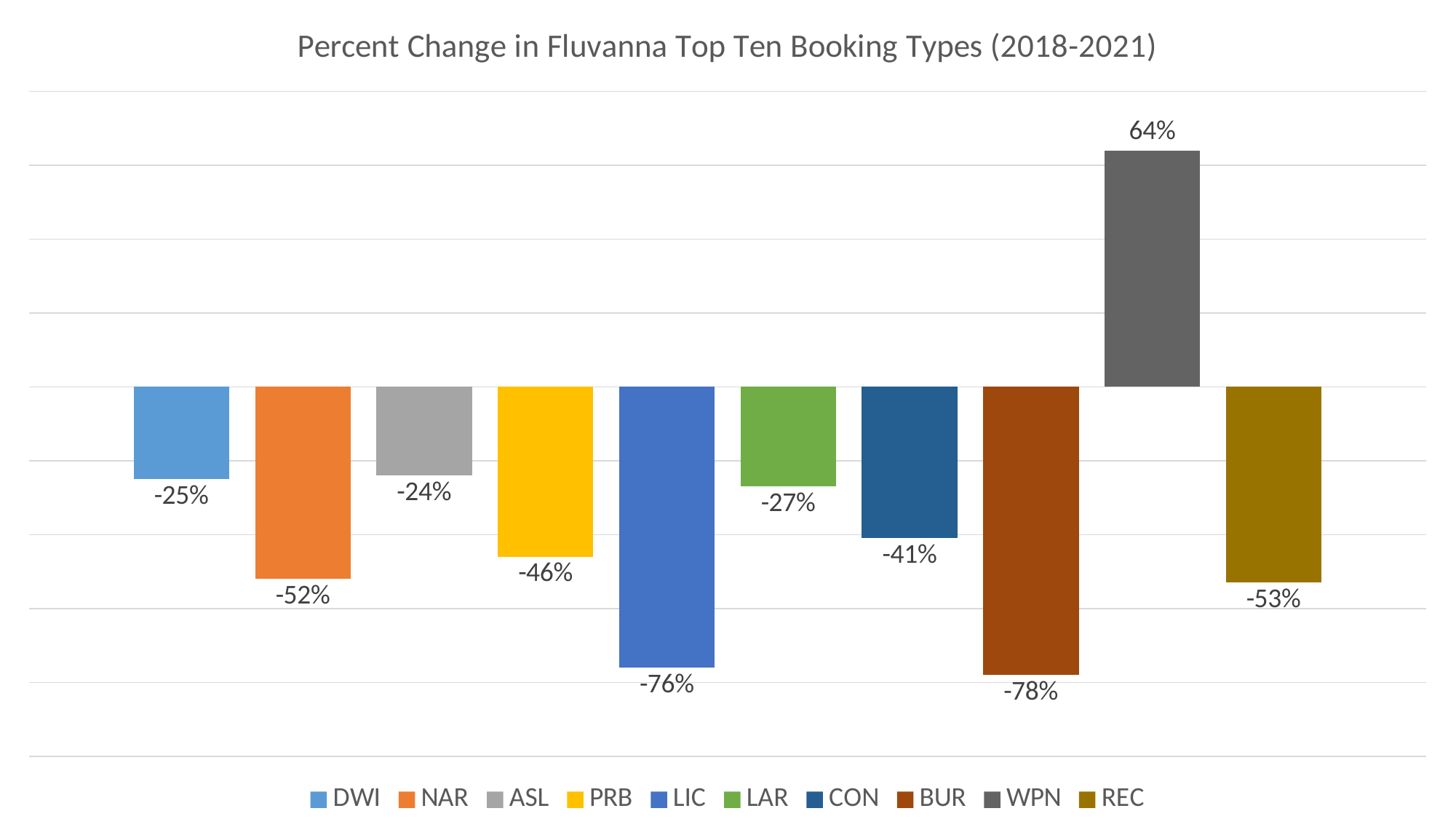
What is the difference between the percent change for REC and the percent change for DWI? 28 percentage points What is the percent change for WPN? 64% Which booking type has the lowest percent change? BUR How many booking types show a positive percent change? 1 How many entries does the legend list? 10 What is the percent change for LIC? -76% What is the title of the chart? Percent Change in Fluvanna Top Ten Booking Types (2018-2021) What is the percent change for NAR? -52% What kind of chart is shown on the slide? Bar chart Which booking type has the highest percent change? WPN How many booking types are shown in the chart? 10